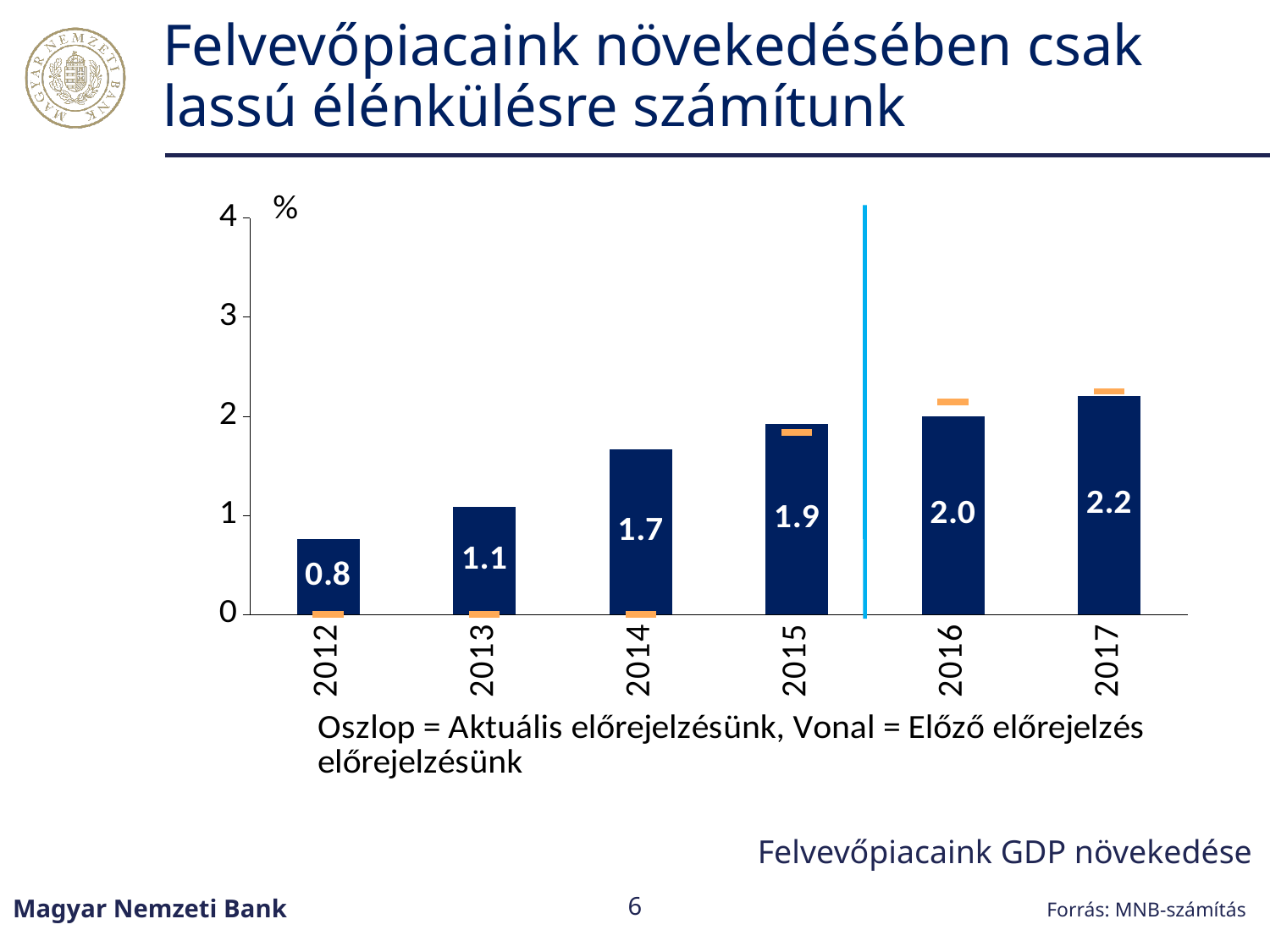
Do the values rise or fall from 2012 to 2017? rise What is the value for 2012? 0.8 How many years are shown on the x axis? 6 Which year has the lowest value? 2012 What is the difference between the values for 2017 and 2012? 1.4 What is the difference between the values for 2015 and 2013? 0.8 What is the value for 2014? 1.7 Which year has the highest value? 2017 What is the value for 2017? 2.2 What kind of chart is shown on the slide? bar chart Is the value for 2014 greater or less than 2? less Which is larger, the value for 2013 or the value for 2016? 2016